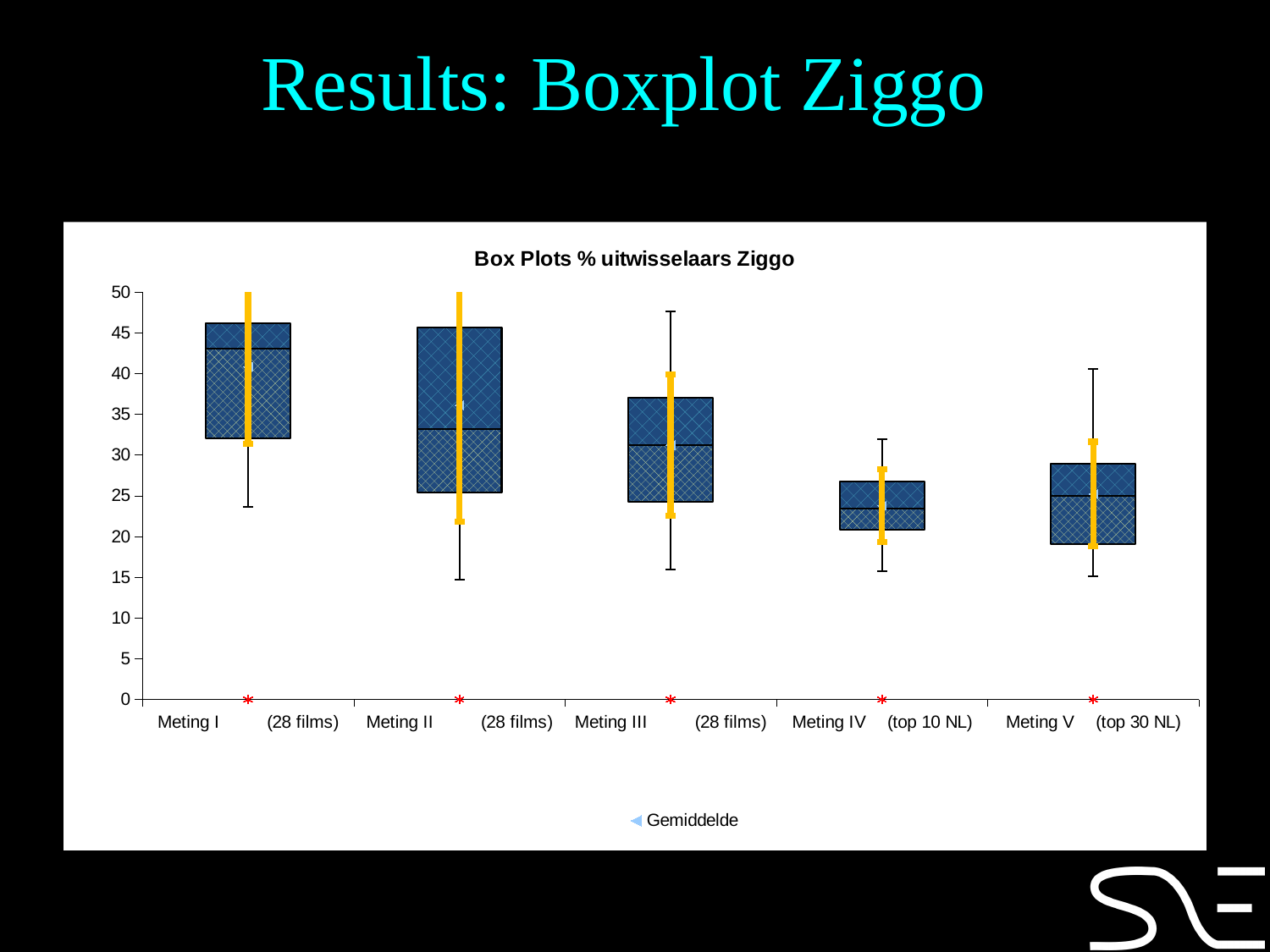
How many entries does the legend list? 1 What is the title of the chart? Box Plots % uitwisselaars Ziggo What kind of chart is shown on the slide? Box plot Is the bottom of the lower whisker for Meting II greater or less than 20? less Which has the higher median, Meting I or Meting IV? Meting I Is the median line for Meting IV greater or less than 25? less What is the legend entry shown below the chart? Gemiddelde Is the median line for Meting I greater or less than 40? greater Which category has the highest median line? Meting I How many categories (metingen) are plotted along the x axis? 5